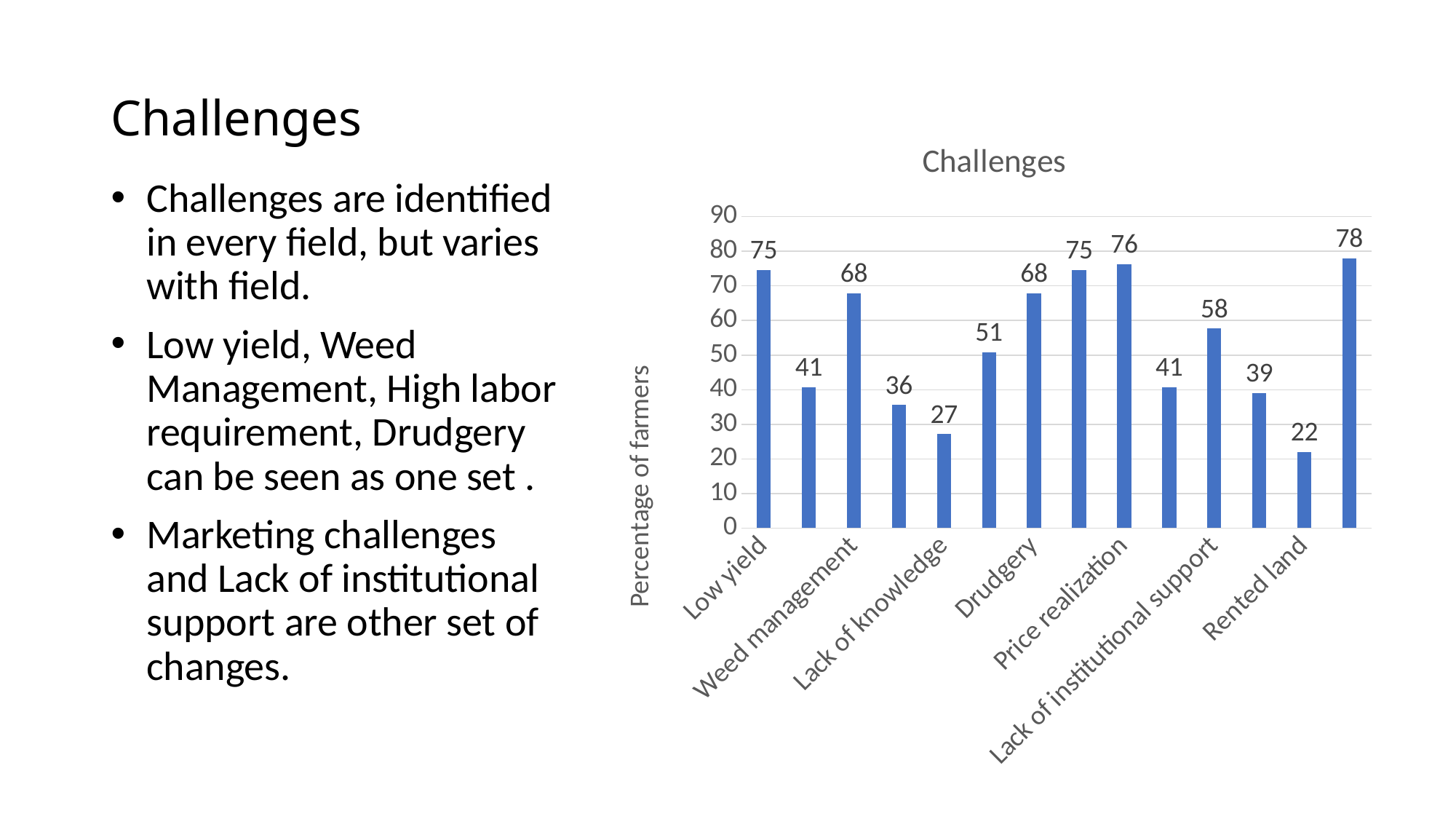
What is the value for Lack of knowledge? 27 What is the label on the vertical axis? Percentage of farmers What is the value for Rented land? 22 What kind of chart is shown? Bar chart What is the difference between the values for Low yield and Lack of knowledge? 48 Which labeled category has the lowest value? Rented land Which is larger, the value for Drudgery or the value for Lack of institutional support? Drudgery What is the value for Lack of institutional support? 58 What is the value for Weed management? 68 How many bars are plotted in the chart? 14 What is the value for Price realization? 76 What is the value for Low yield? 75